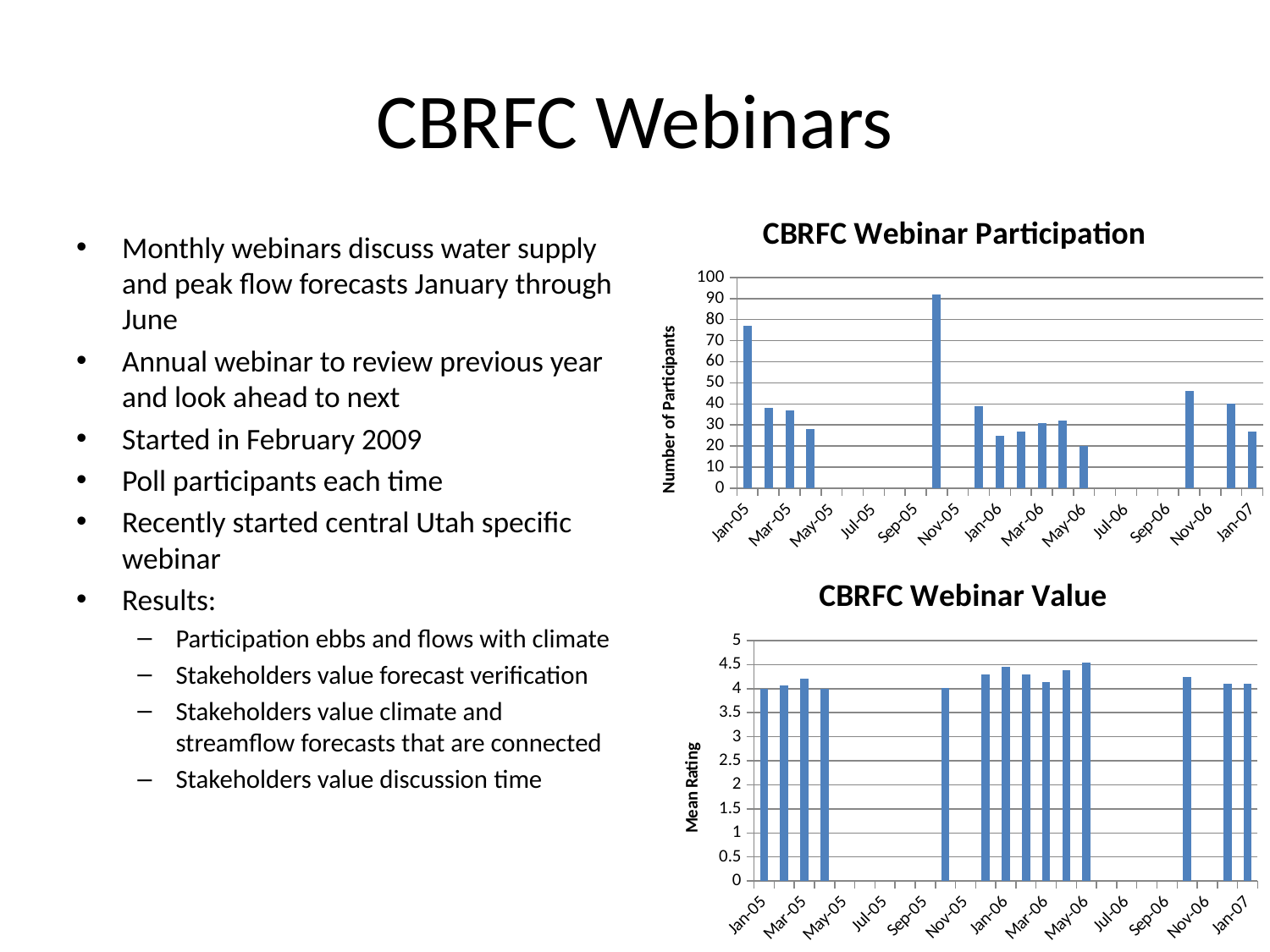
In the CBRFC Webinar Participation chart, is the value for Jan-05 greater or less than 70? greater What kind of chart is the CBRFC Webinar Participation chart? bar chart In the CBRFC Webinar Participation chart, which month has the highest number of participants? Nov-05 What is the y-axis title of the CBRFC Webinar Participation chart? Number of Participants In the CBRFC Webinar Participation chart, is the value for Nov-06 greater or less than 40? greater In the CBRFC Webinar Value chart, is the value for Jan-05 greater or less than 3.5? greater In the CBRFC Webinar Participation chart, which is larger, the value for Nov-05 or the value for Nov-06? Nov-05 In the CBRFC Webinar Participation chart, which is larger, the value for Jan-05 or the value for Jan-06? Jan-05 What is the y-axis title of the CBRFC Webinar Value chart? Mean Rating